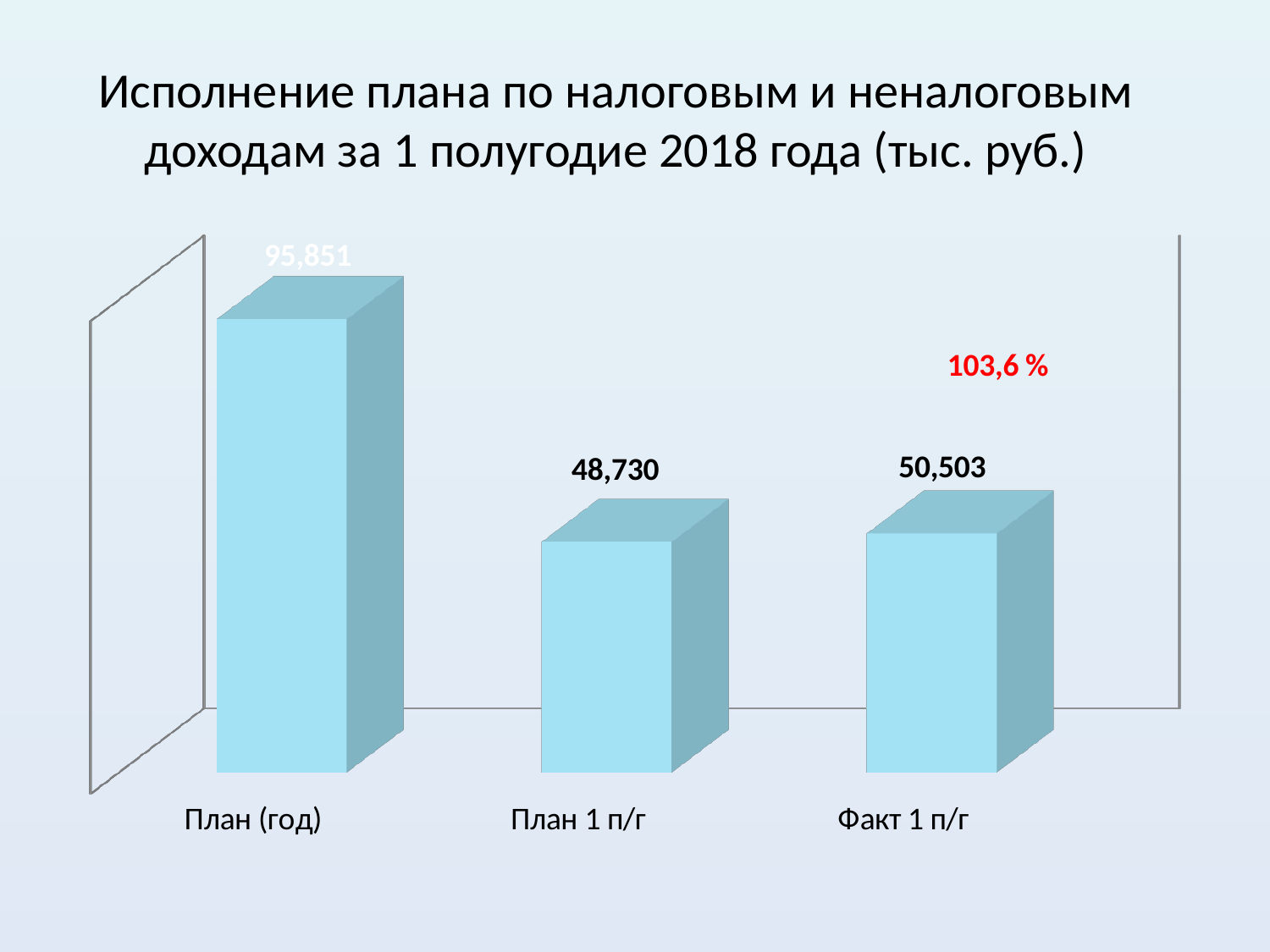
What is the difference between Факт 1 п/г and План 1 п/г? 1,773 How many categories are shown in the chart? 3 What kind of chart is shown on the slide? Bar chart What is the value for План (год)? 95,851 Which category has the lowest value? План 1 п/г What is the title of the chart? Исполнение плана по налоговым и неналоговым доходам за 1 полугодие 2018 года (тыс. руб.) Which category has the highest value? План (год) What is the value for План 1 п/г? 48,730 What is the value for Факт 1 п/г? 50,503 Which is larger, План 1 п/г or Факт 1 п/г? Факт 1 п/г What is the difference between План (год) and План 1 п/г? 47,121 What percentage is shown in red on the chart? 103,6 %